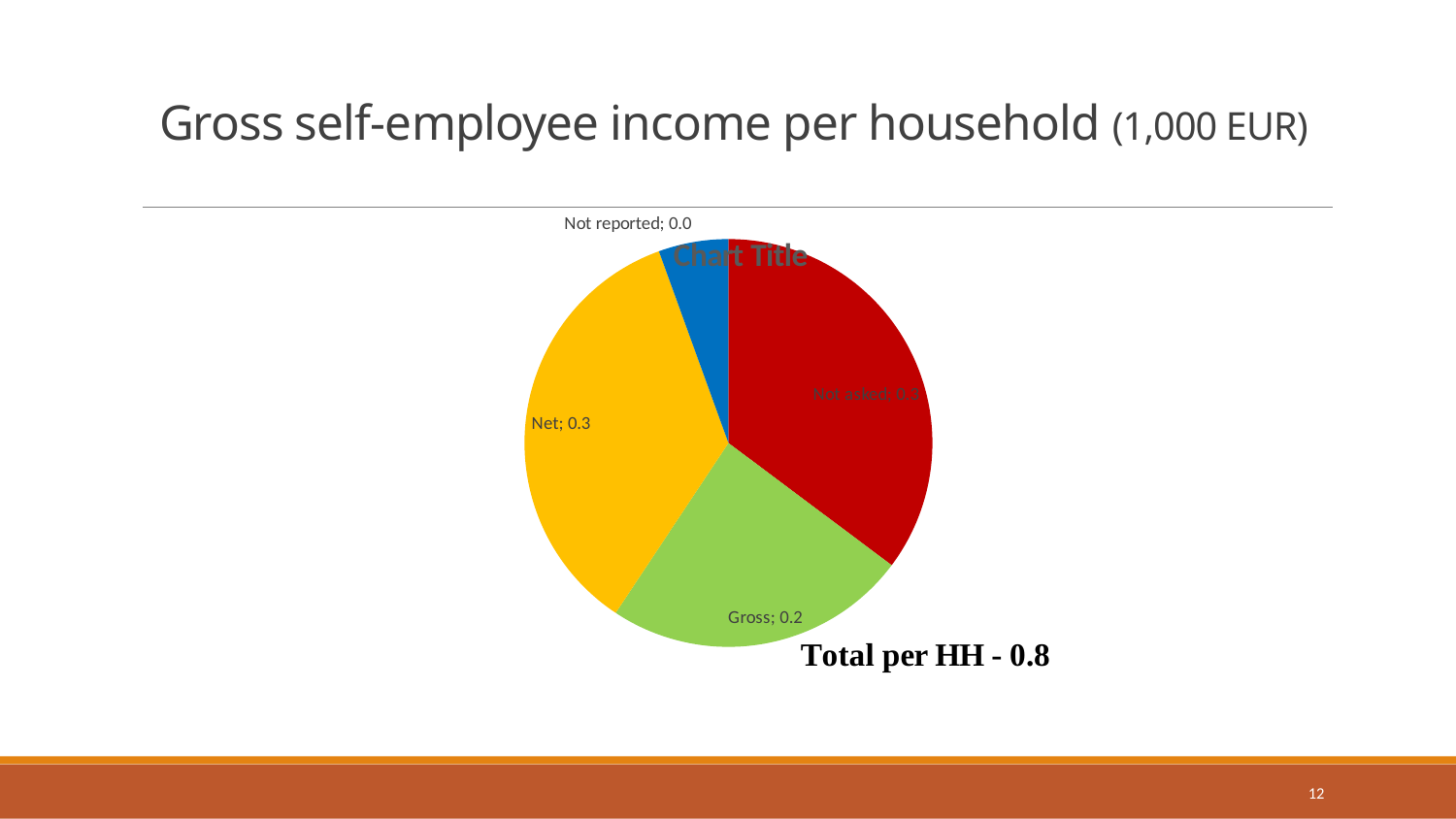
What is the value shown for the Net slice? 0.3 Which is larger, the Net slice or the Gross slice? Net What type of chart is shown on the slide? pie chart What is the difference between the Net value and the Gross value? 0.1 How many slices does the pie chart have? 4 What colour is the Net slice of the pie? yellow What is the value shown for the Gross slice? 0.2 What is the value shown for the Not reported slice? 0.0 What total per household is stated in the text below the pie chart? 0.8 Which is larger, the Gross slice or the Not reported slice? Gross Which slice of the pie has the smallest value? Not reported